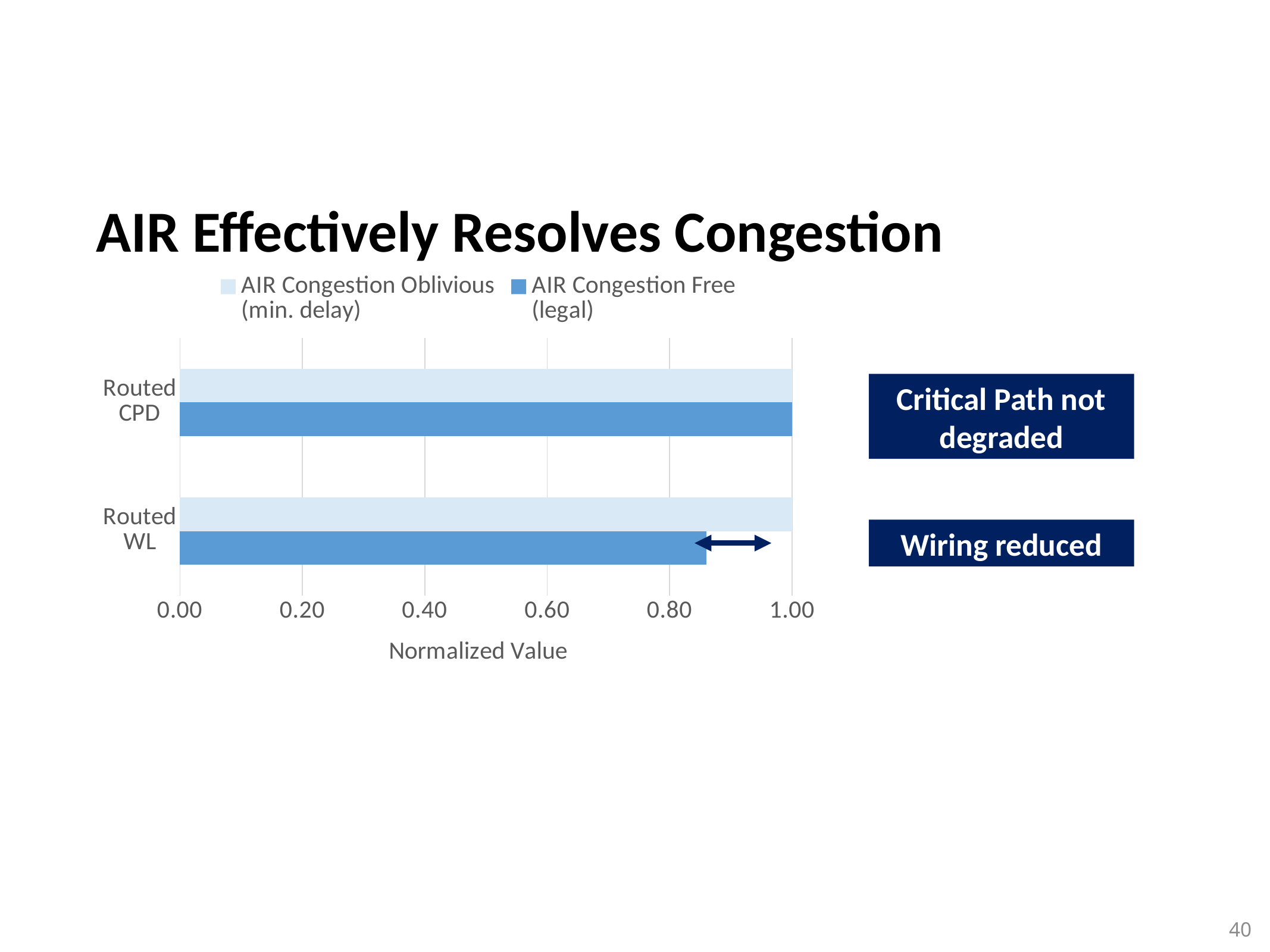
Is the value for Routed WL in the AIR Congestion Free (legal) series greater or less than 0.80? greater How many series does the chart's legend list? 2 What is the value for Routed CPD in the AIR Congestion Free (legal) series? 1.00 How many categories are shown on the chart's vertical axis? 2 Is the value for Routed WL in the AIR Congestion Free (legal) series greater or less than 1.00? less For Routed WL, which series has the larger value: AIR Congestion Oblivious (min. delay) or AIR Congestion Free (legal)? AIR Congestion Oblivious (min. delay) What is the value for Routed CPD in the AIR Congestion Oblivious (min. delay) series? 1.00 What is the value for Routed WL in the AIR Congestion Oblivious (min. delay) series? 1.00 What kind of chart is shown on the slide? bar chart What is the title of the chart's horizontal axis? Normalized Value Which series is drawn in the darker blue colour? AIR Congestion Free (legal) In the AIR Congestion Free (legal) series, which category has the lowest value? Routed WL